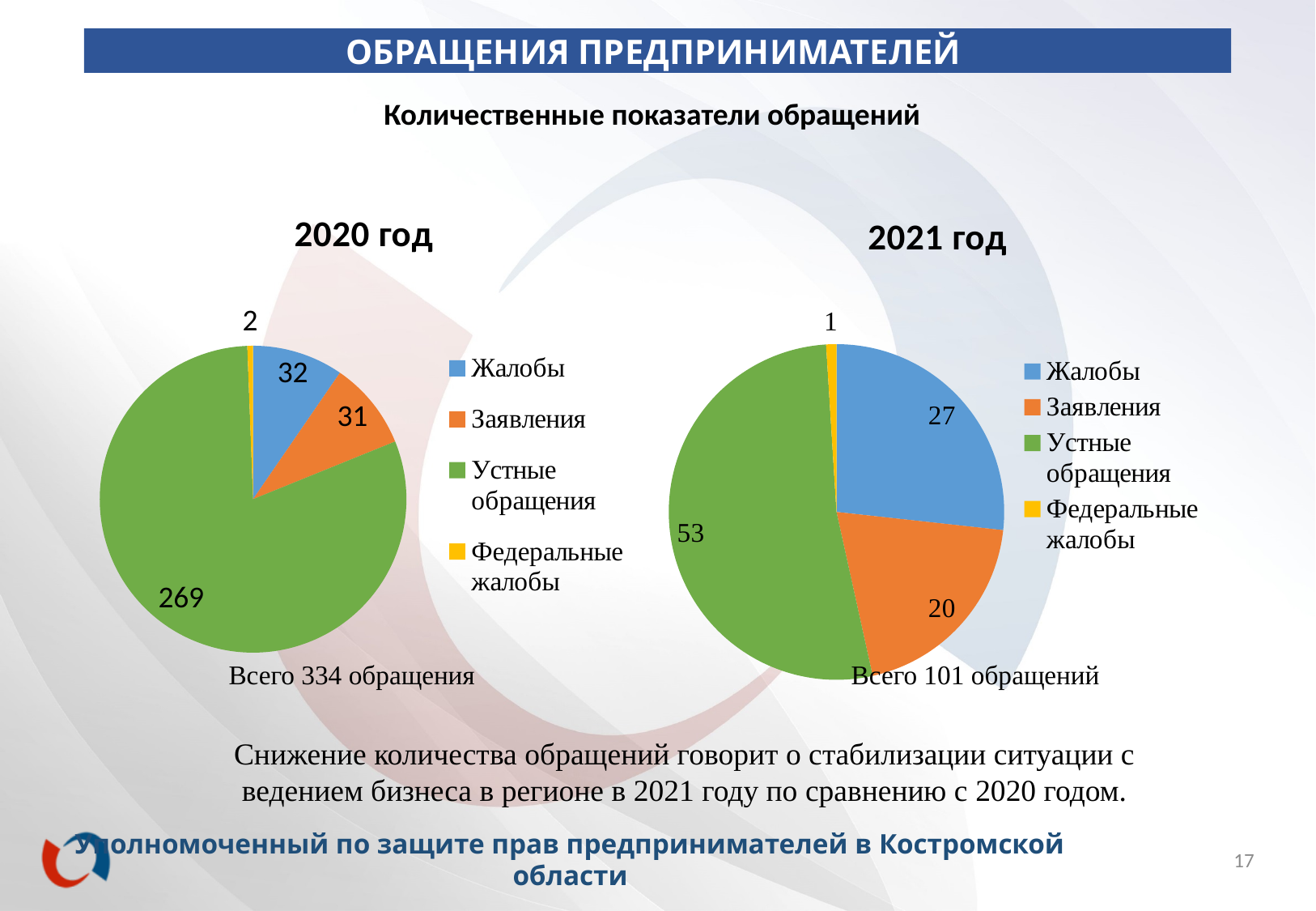
In the 2021 год pie chart, which category has the largest value? Устные обращения What type of chart is used for 2021 год? Pie chart What is the total number of обращения shown for the 2020 год chart? 334 In the 2021 год pie chart, what is the difference between Жалобы and Заявления? 7 In the 2020 год pie chart, which category has the smallest value? Федеральные жалобы In the 2021 год pie chart, what is the value for Заявления? 20 In the 2020 год pie chart, what is the difference between Устные обращения and Жалобы? 237 How many slices does the 2020 год pie chart have? 4 In the 2021 год pie chart, which colour represents Федеральные жалобы? Yellow In the 2020 год pie chart, what is the value for Федеральные жалобы? 2 In the 2020 год pie chart, what is the value for Устные обращения? 269 In the 2021 год pie chart, which is larger: Жалобы or Заявления? Жалобы